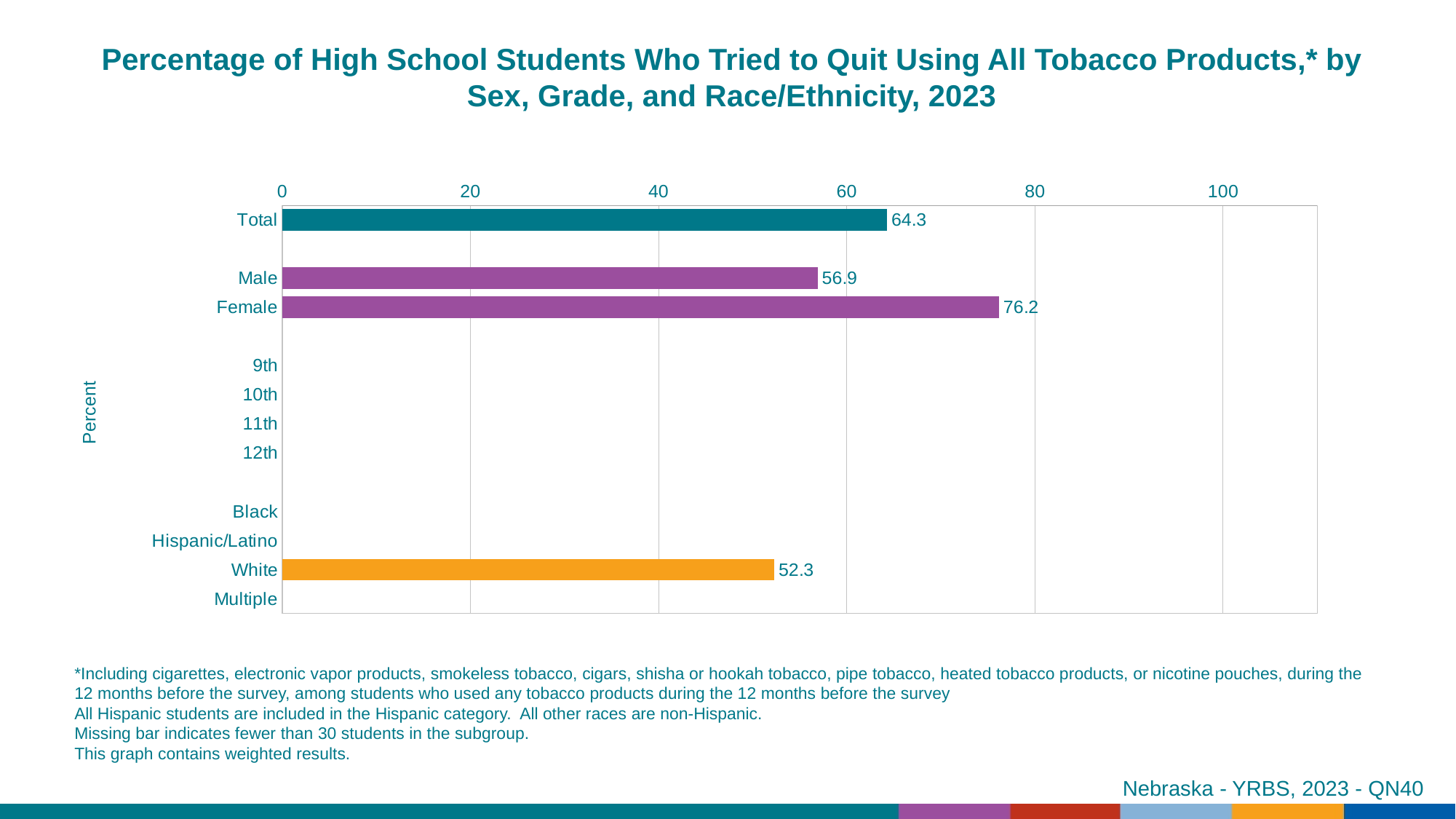
What is the value for Total? 64.3 What does a missing bar indicate, according to the note on the slide? Fewer than 30 students in the subgroup Which is larger, the value for Total or the value for Male? Total Which category has the lowest value among the plotted bars? White What is the value for White? 52.3 Which category has the highest value among the plotted bars? Female What is the difference between the Female and Male values? 19.3 What kind of chart is shown? bar chart How many categories have a bar plotted? 4 What is the value for Male? 56.9 Is the value for Female greater or less than 60? greater What is the value for Female? 76.2